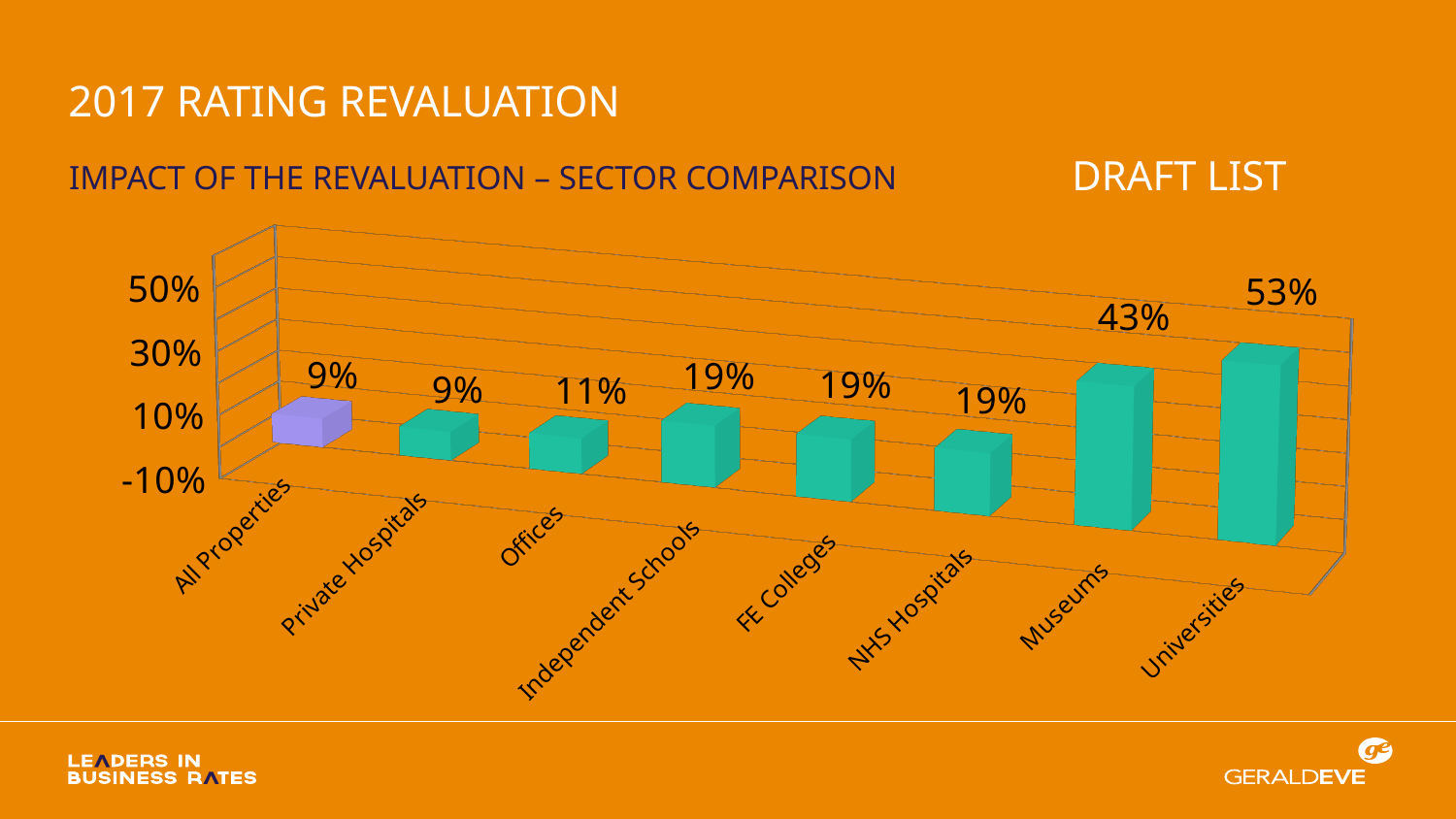
What is the value for Museums? 43% Is the value for Universities greater or less than 30%? greater Which bar is shown in a different colour from the others? All Properties What is the value for Universities? 53% What kind of chart is shown on the slide? bar chart What is the difference between the values for Independent Schools and Offices? 8% What is the value for All Properties? 9% What is the difference between the values for Universities and Museums? 10% How many categories are shown on the x axis? 8 What is the value for Offices? 11% Which is larger, the value for Museums or the value for NHS Hospitals? Museums Which category has the highest value? Universities